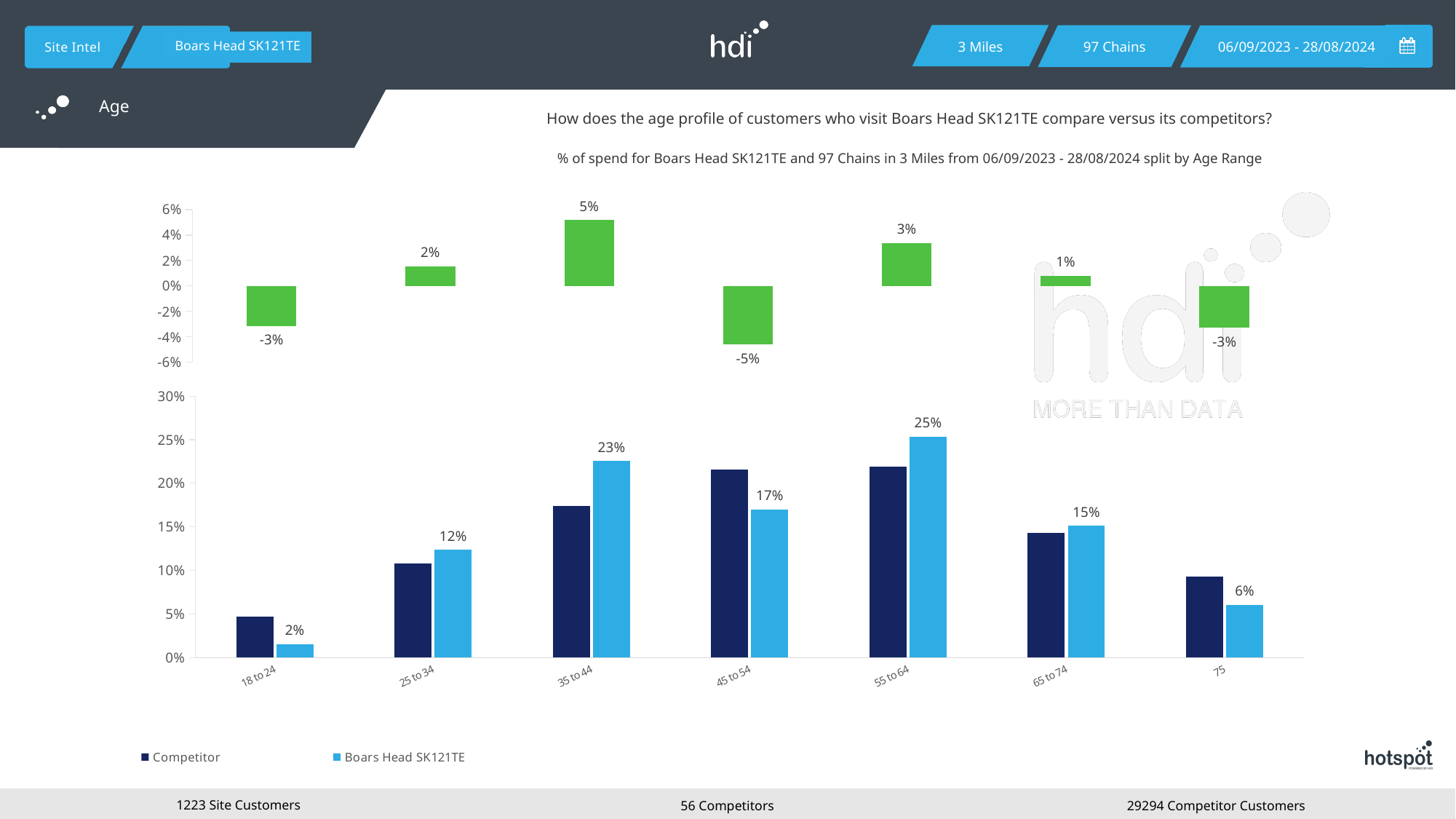
In the bottom chart, which age range has the highest % of spend for Boars Head SK121TE? 55 to 64 In the bottom chart, is the Competitor value for 45 to 54 greater or less than 20%? greater In the bottom chart, what is the % of spend for Boars Head SK121TE in the 35 to 44 age range? 23% How many series does the legend of the bottom chart list? 2 In the top chart, what is the value shown for the 45 to 54 age range? -5% In the bottom chart, what is the difference between the Boars Head SK121TE values for 55 to 64 and 65 to 74? 10% In the bottom chart, which is larger for the 45 to 54 age range: Competitor or Boars Head SK121TE? Competitor In the bottom chart, which age range has the lowest % of spend for Boars Head SK121TE? 18 to 24 In the top chart, which age range has the highest value? 35 to 44 How many age range categories are shown on the x axis of the bottom chart? 7 In the bottom chart, what is the % of spend for Boars Head SK121TE in the 18 to 24 age range? 2% In the bottom chart, is the Competitor value for 75 greater or less than 10%? less